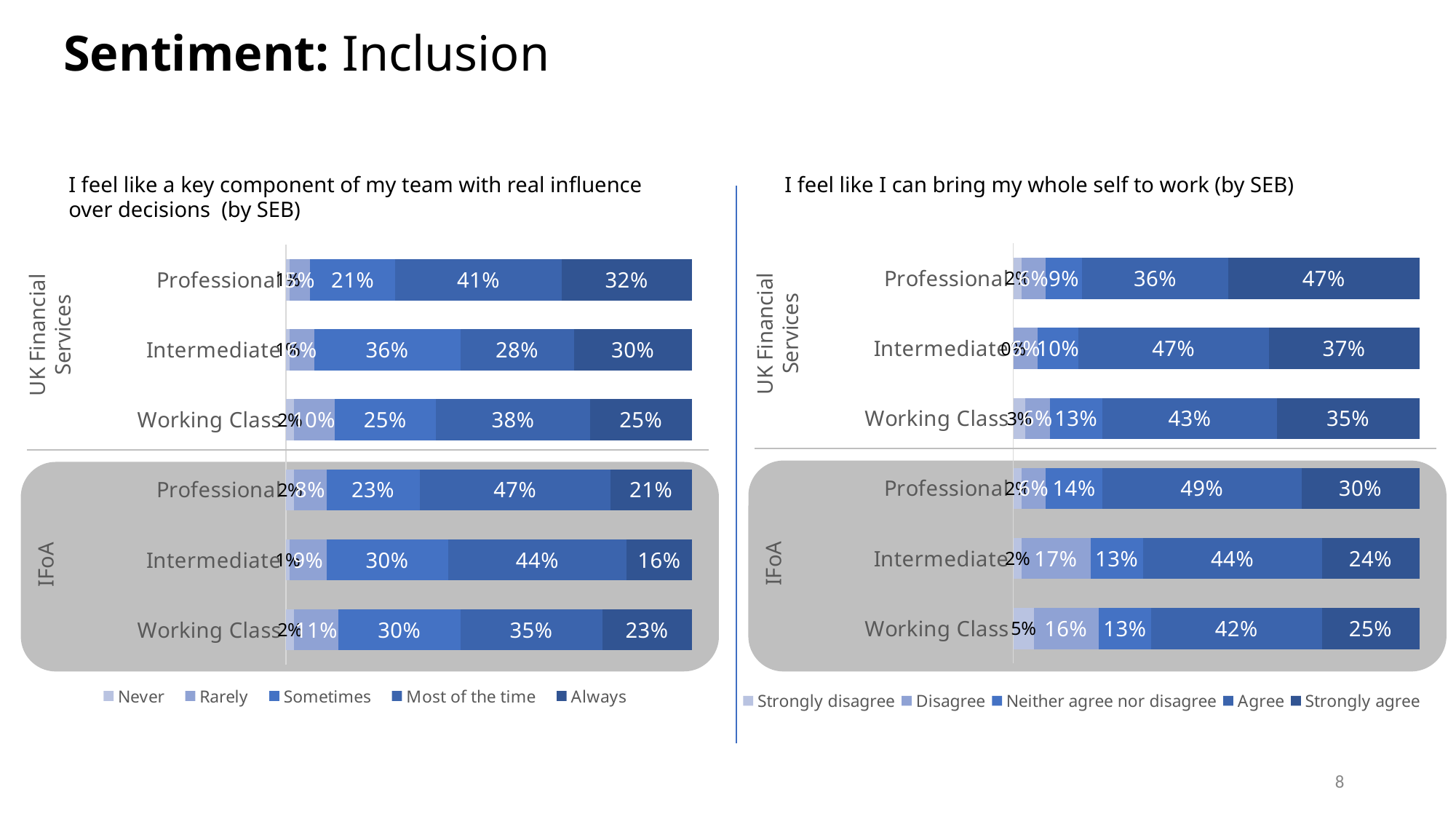
In the chart 'I feel like a key component of my team with real influence over decisions (by SEB)', what percentage of UK Financial Services Professional respondents answered 'Most of the time'? 41% How many series does the legend of the chart 'I feel like I can bring my whole self to work (by SEB)' list? 5 What type of chart is 'I feel like a key component of my team with real influence over decisions (by SEB)'? Stacked bar chart In the chart 'I feel like a key component of my team with real influence over decisions (by SEB)', what is the difference between the 'Most of the time' values for IFoA Professional and IFoA Working Class? 12% In the chart 'I feel like a key component of my team with real influence over decisions (by SEB)', which group has the highest 'Always' percentage? UK Financial Services Professional In the chart 'I feel like a key component of my team with real influence over decisions (by SEB)', what is the 'Sometimes' value for UK Financial Services Intermediate? 36% In the chart 'I feel like I can bring my whole self to work (by SEB)', what is the 'Disagree' value for IFoA Working Class? 16% In the chart 'I feel like I can bring my whole self to work (by SEB)', which is larger: the 'Agree' value for UK Financial Services Intermediate or for UK Financial Services Working Class? UK Financial Services Intermediate In the chart 'I feel like a key component of my team with real influence over decisions (by SEB)', what is the 'Always' value for IFoA Intermediate? 16% In the chart 'I feel like I can bring my whole self to work (by SEB)', which group has the lowest 'Strongly agree' percentage? IFoA Intermediate In the chart 'I feel like I can bring my whole self to work (by SEB)', what percentage of UK Financial Services Professional respondents answered 'Strongly agree'? 47% In the chart 'I feel like I can bring my whole self to work (by SEB)', what is the 'Agree' value for IFoA Professional? 49%